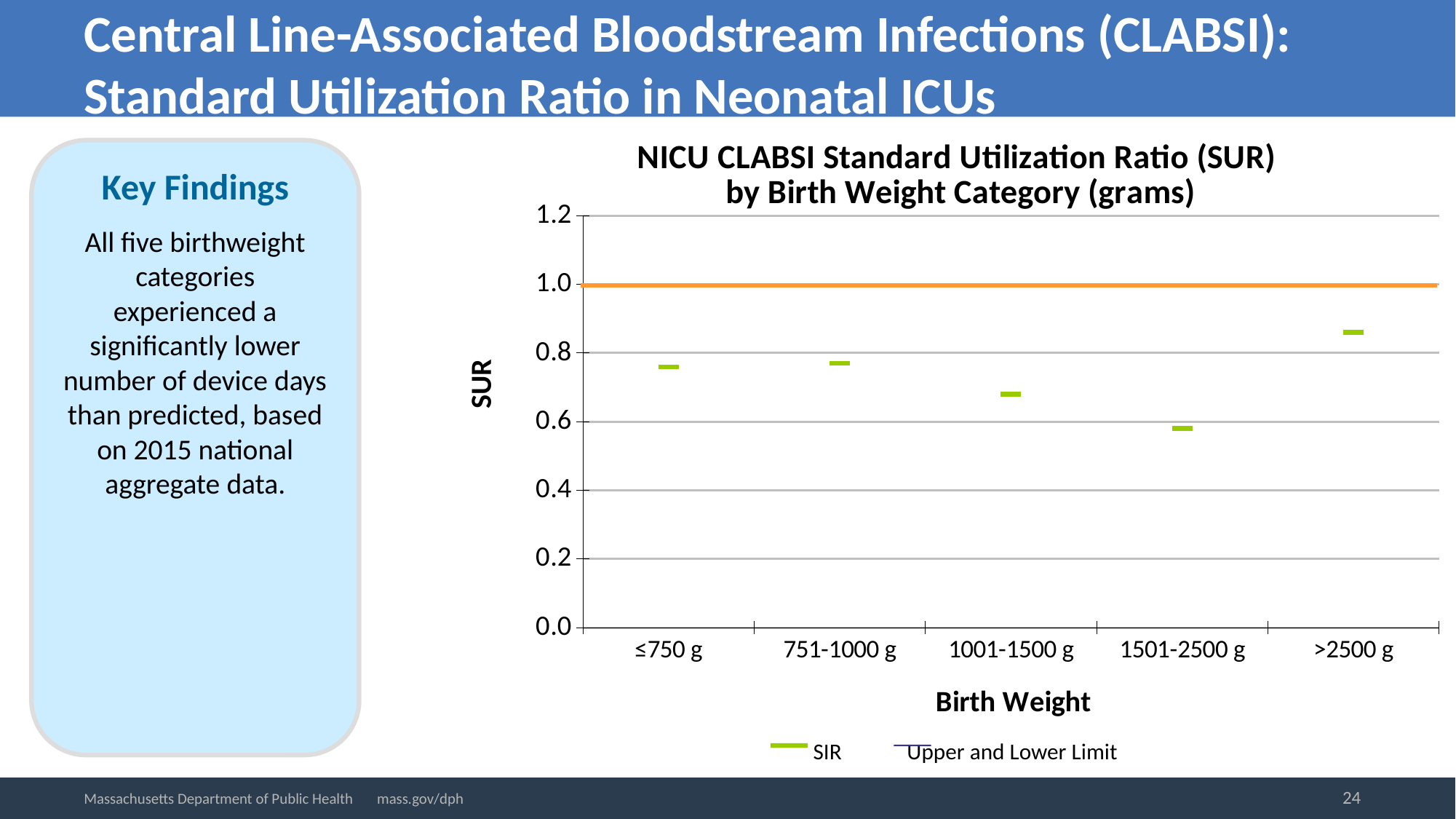
At what SUR value does the orange Upper and Lower Limit line sit? 1.0 Is the SIR value for 751-1000 g greater or less than 1.0? less Which birth weight category has the highest SIR value? >2500 g How many series does the legend list? 2 Which birth weight category has the lowest SIR value? 1501-2500 g Is the SIR value for ≤750 g greater or less than 0.8? less How many birth weight categories are shown on the x axis? 5 What is the label on the y axis of the chart? SUR Which has the larger SIR value, 1001-1500 g or 1501-2500 g? 1001-1500 g Is the SIR value for 1001-1500 g greater or less than 0.6? greater What is the title of the chart? NICU CLABSI Standard Utilization Ratio (SUR) by Birth Weight Category (grams)